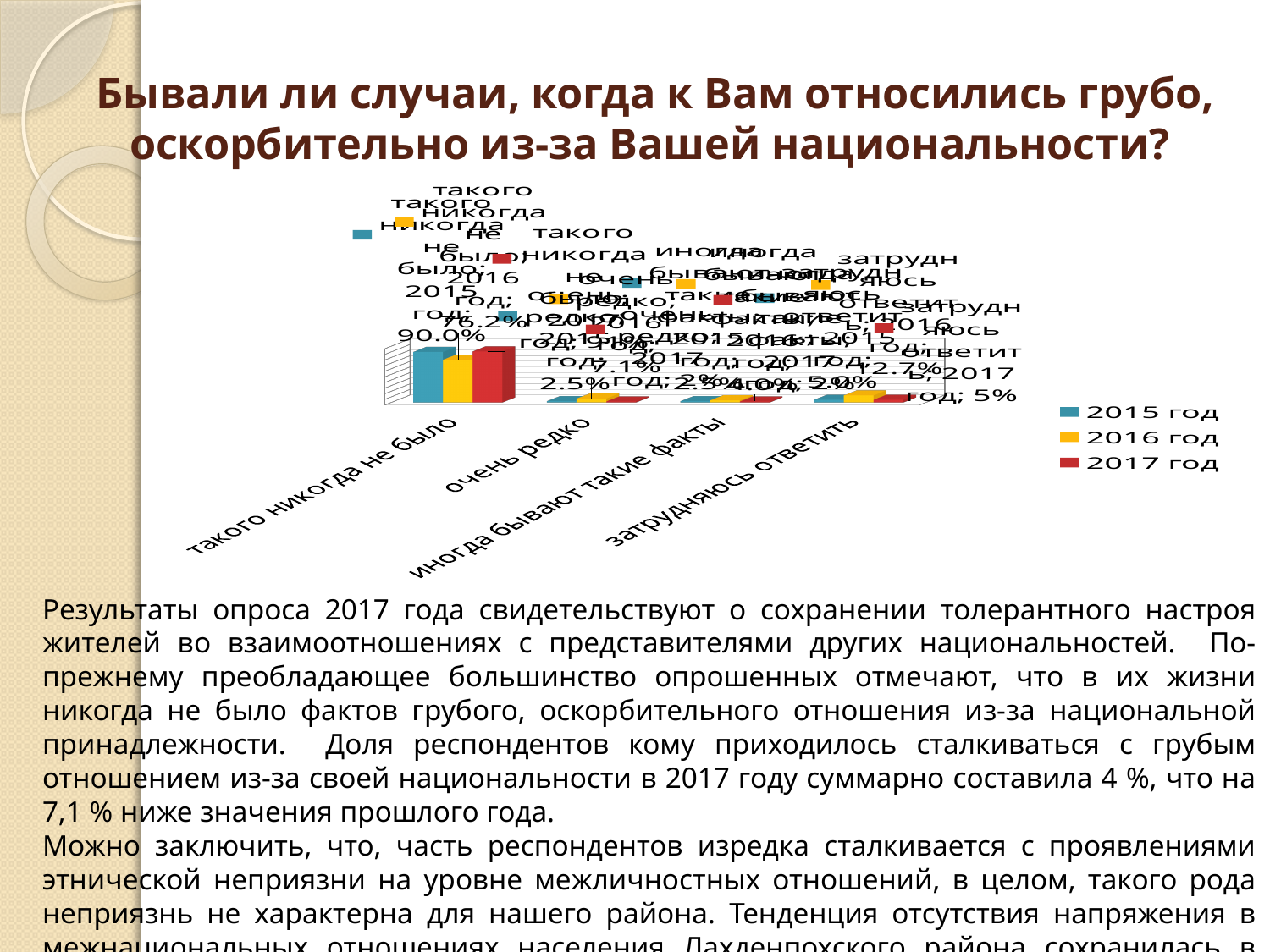
Which category has the highest values in the chart? такого никогда не было For the 2015 год series, which is larger: the value for 'такого никогда не было' or for 'очень редко'? такого никогда не было How many series does the chart legend list? 3 Which colour represents the 2016 год series in the chart? yellow What kind of chart is shown on the slide? bar chart What is the first category on the x axis of the chart? такого никогда не было For the 2017 год series, which is larger: the value for 'такого никогда не было' or for 'иногда бывают такие факты'? такого никогда не было How many categories are shown along the x axis of the chart? 4 Which years are listed in the chart legend? 2015 год, 2016 год, 2017 год